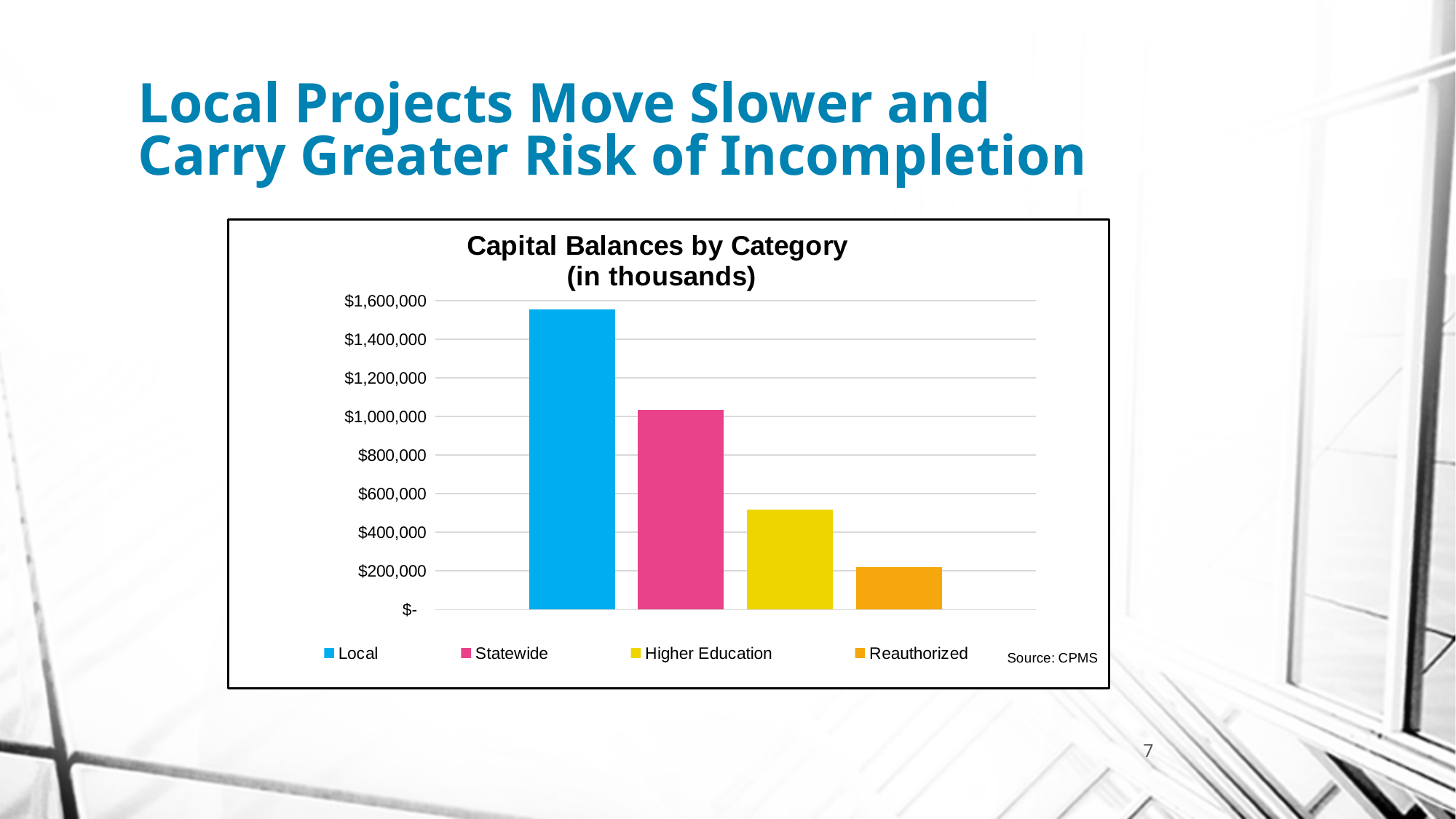
Is the value for Higher Education greater or less than $400,000? greater Which category has the highest capital balance? Local Is the value for Reauthorized greater or less than $400,000? less How many entries does the legend list? 4 Do the bar values rise or fall moving from left to right across the chart? fall Which has a larger capital balance, Statewide or Higher Education? Statewide What is the title of the chart? Capital Balances by Category (in thousands) Is the value for Local greater or less than $1,400,000? greater How many bars are plotted in the chart? 4 Which category has the lowest capital balance? Reauthorized What kind of chart is shown on the slide? bar chart